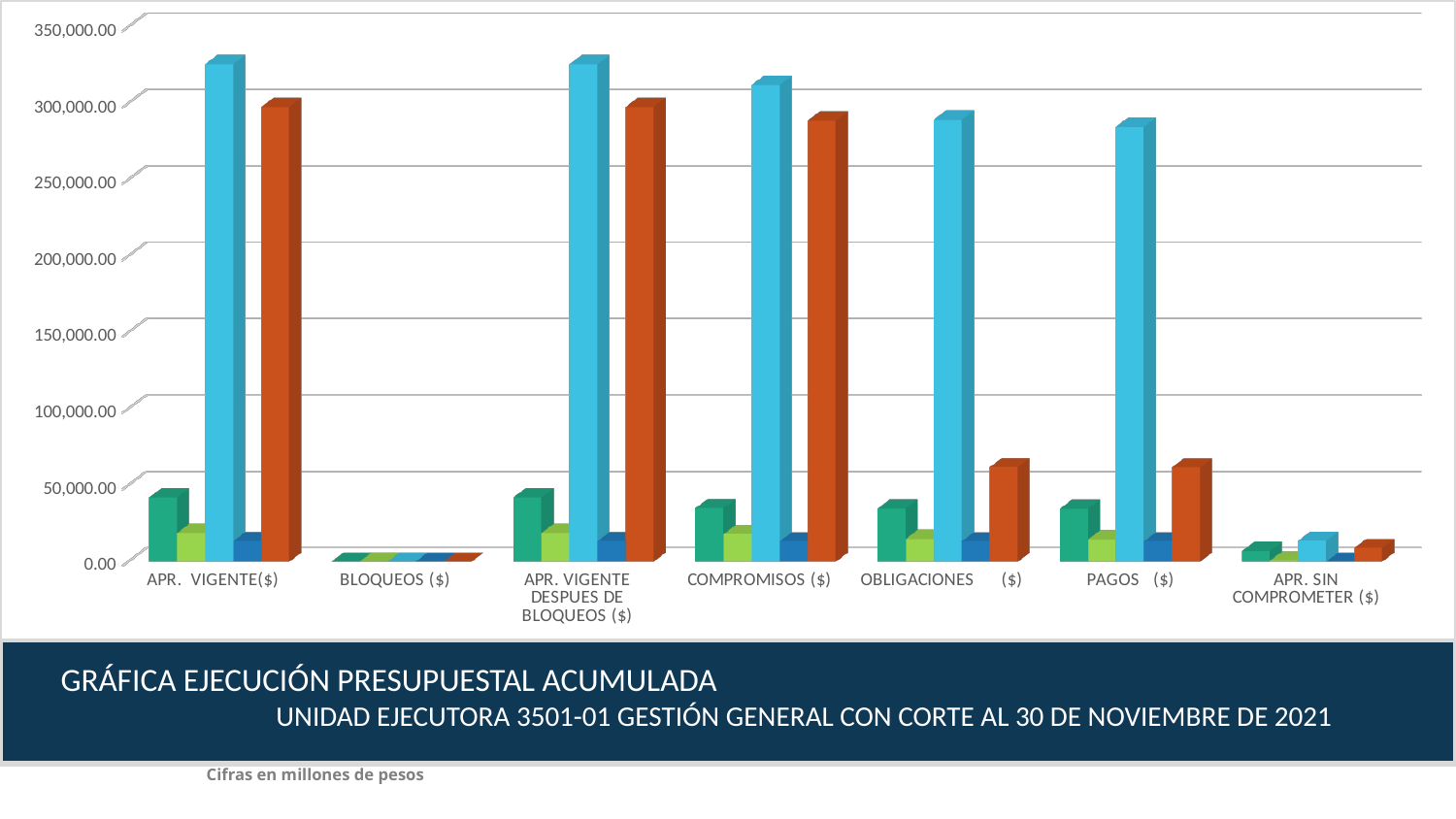
How many bars are plotted for each category in the chart? 5 What kind of chart is shown on the slide? Bar chart Is the value of the orange bar for COMPROMISOS ($) greater or less than 300,000.00? less Which is larger: the orange bar for COMPROMISOS ($) or the orange bar for OBLIGACIONES ($)? COMPROMISOS ($) Is the value of the light blue bar for PAGOS ($) greater or less than 250,000.00? greater According to the note below the chart, in what units are the figures expressed? Millones de pesos Is the value of the orange bar for OBLIGACIONES ($) greater or less than 50,000.00? greater Which category has the lowest values, with all its bars at essentially zero? BLOQUEOS ($) How many categories are shown along the x axis of the chart? 7 Which is larger: the light blue bar for APR. VIGENTE($) or the light blue bar for PAGOS ($)? APR. VIGENTE($)